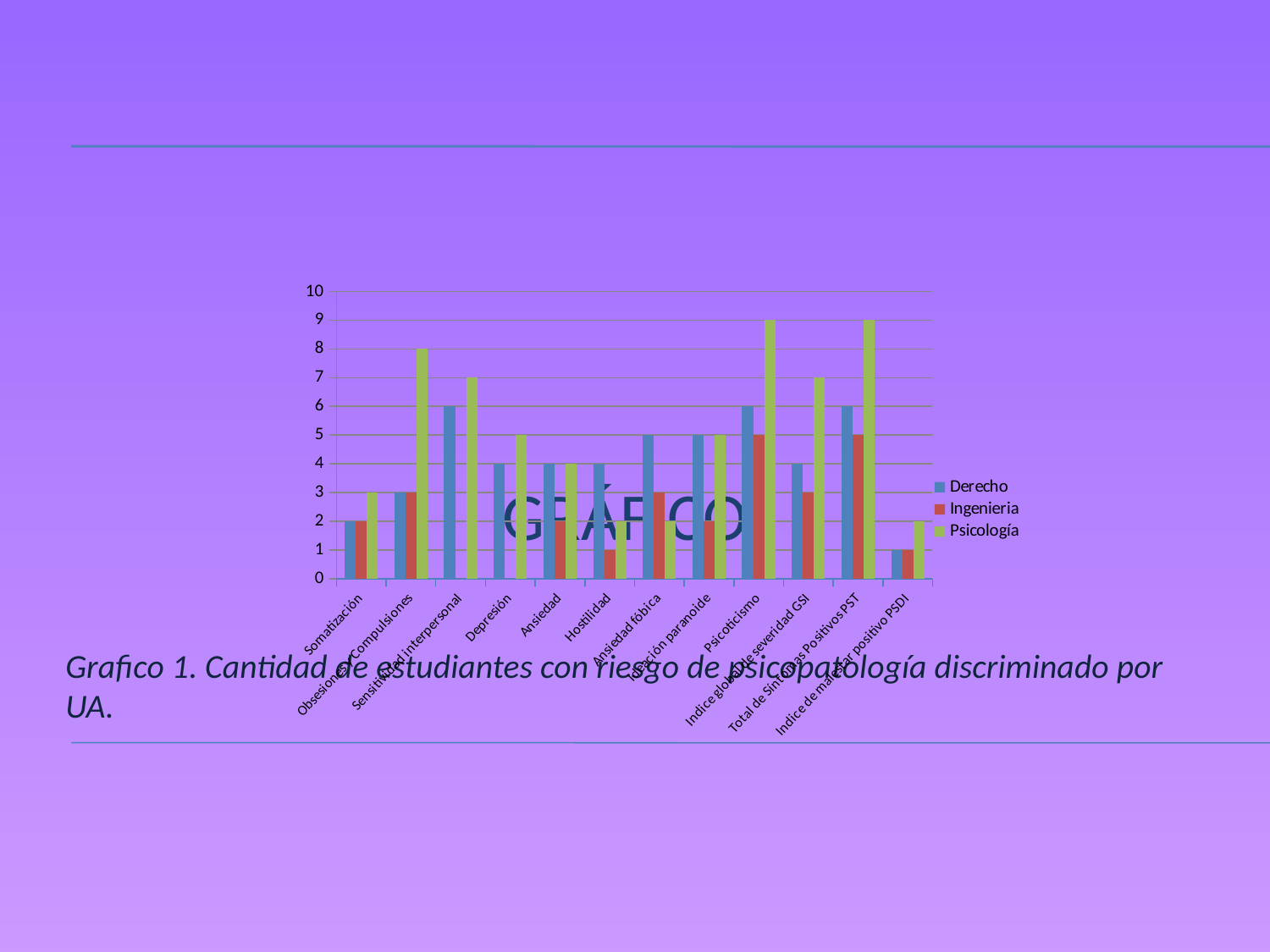
What kind of chart is shown on the slide? bar chart What is the value for Ingenieria in the Psicoticismo category? 5 What is the value for Psicología in the Obsesiones y Compulsiones category? 8 Which series is shown in green in the legend? Psicología Is the value for Psicología in the Psicoticismo category greater or less than 8? greater How many categories are shown on the x axis? 12 In which category does Derecho have its lowest value? Indice de malestar positivo PSDI What is the value for Derecho in the Sensitividad interpersonal category? 6 In the Hostilidad category, which is larger: the Derecho value or the Psicología value? Derecho What is the difference between the Psicología and Derecho values in the Obsesiones y Compulsiones category? 5 How many series does the legend list? 3 Which series has the highest value in the Obsesiones y Compulsiones category? Psicología